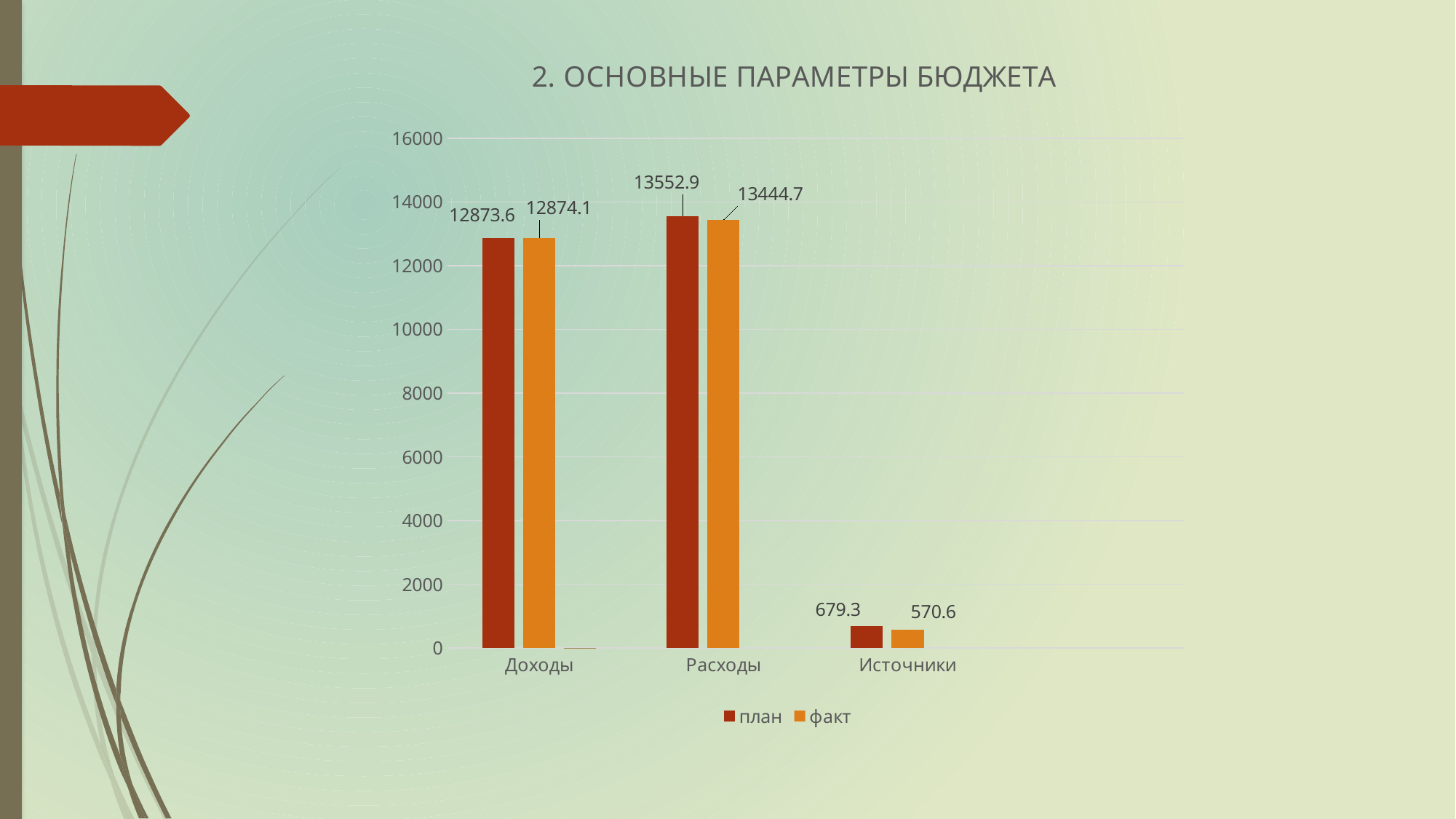
Is the факт value for Доходы greater or less than 12000? greater What is the difference between the план and факт values for Расходы? 108.2 What is the факт value for Источники? 570.6 How many series does the legend list? 2 Which category has the highest план value? Расходы How many categories are shown on the x axis? 3 What is the план value for Доходы? 12873.6 What is the план value for Источники? 679.3 Which category has the lowest факт value? Источники What is the факт value for Расходы? 13444.7 Which is larger for Расходы, план or факт? план What is the difference between the план and факт values for Источники? 108.7